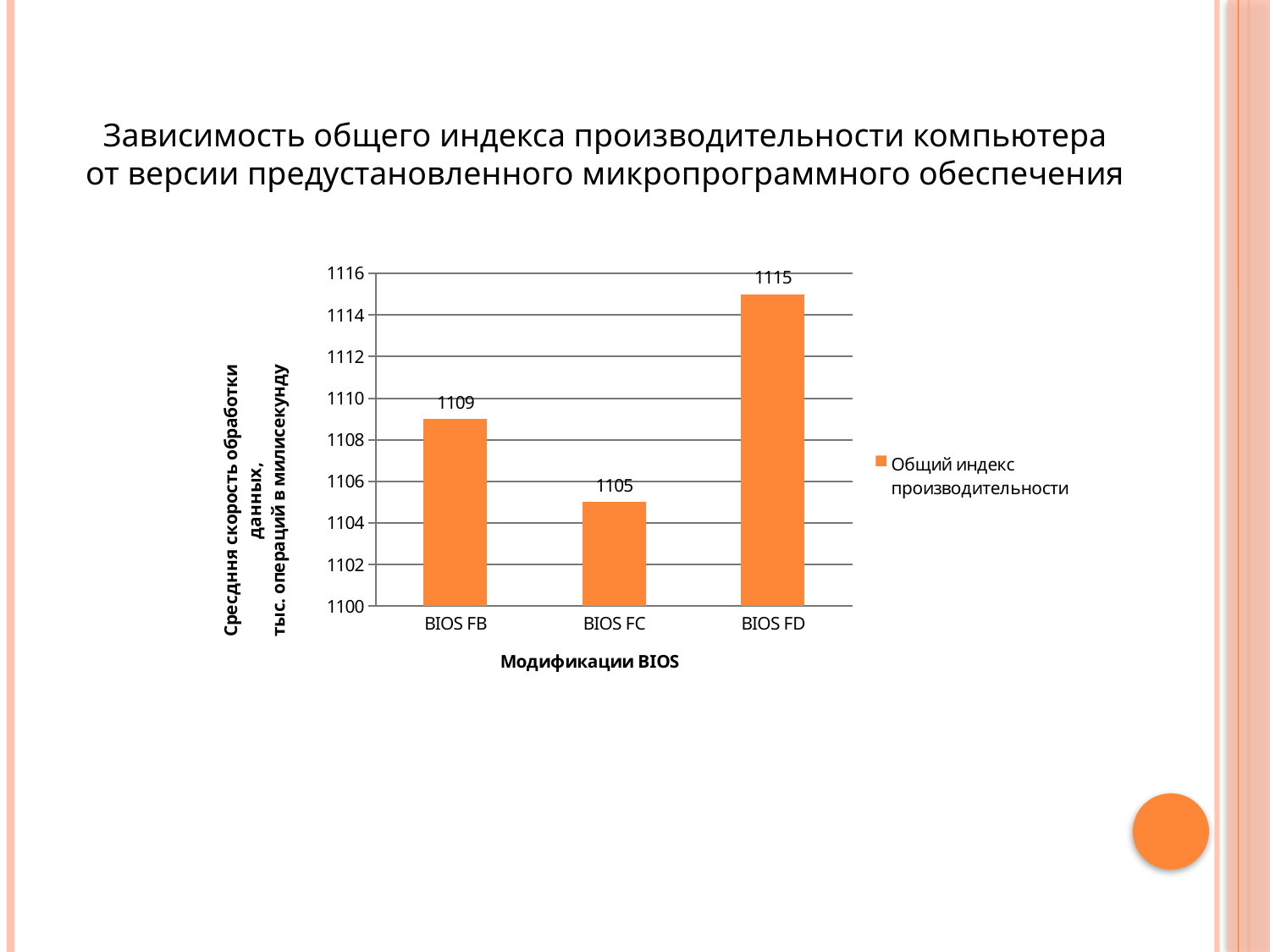
How many series does the legend list? 1 What is the x-axis title of the chart? Модификации BIOS Which is larger, the value for BIOS FB or BIOS FD? BIOS FD What is the value for BIOS FC? 1105 Which BIOS modification has the highest value? BIOS FD How many BIOS modifications are shown on the x axis? 3 Which BIOS modification has the lowest value? BIOS FC What is the value for BIOS FB? 1109 What is the difference between the values for BIOS FB and BIOS FC? 4 What is the value for BIOS FD? 1115 What kind of chart is shown on the slide? bar chart What is the difference between the values for BIOS FD and BIOS FC? 10